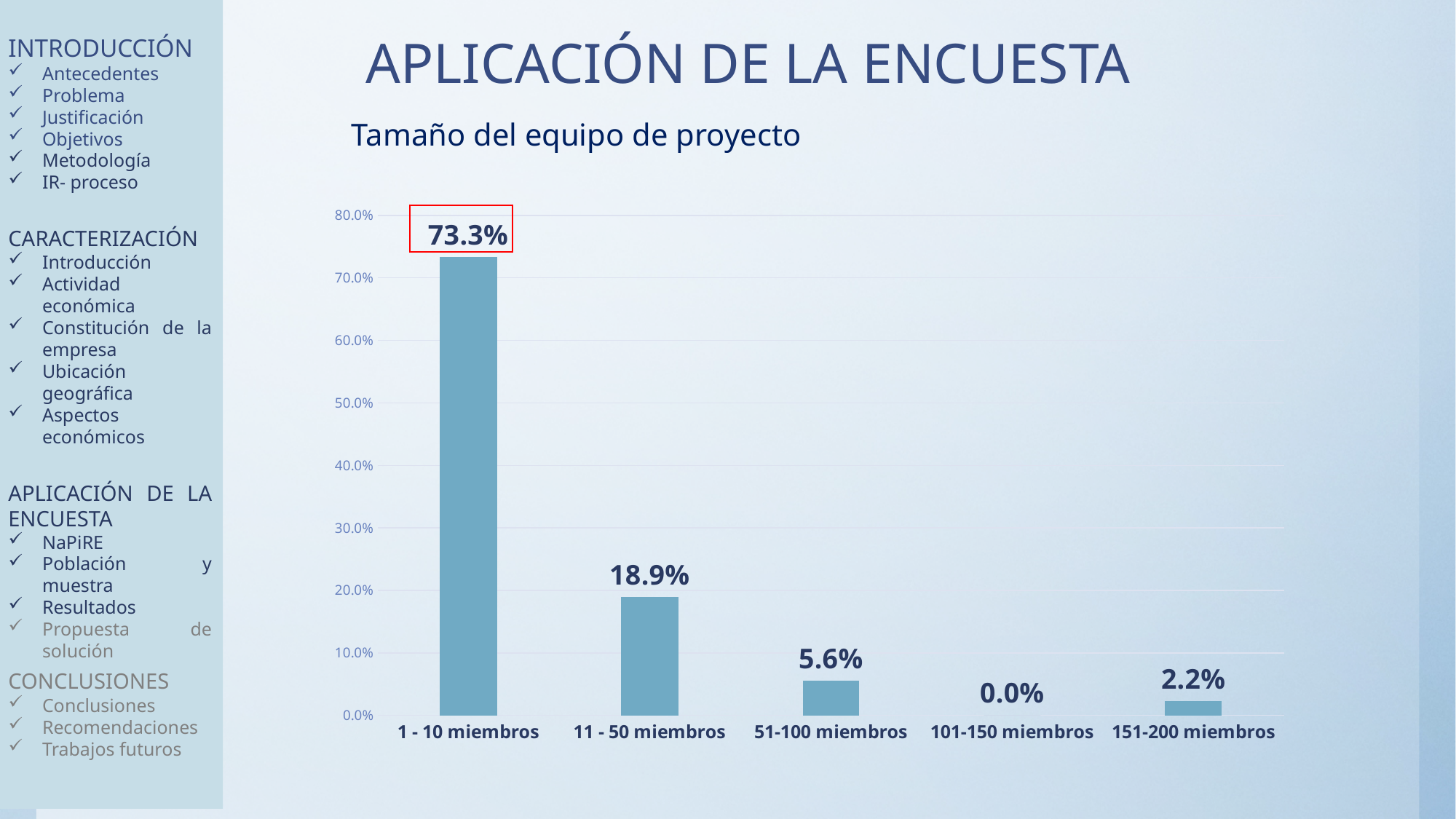
Which category has the lowest value? 101-150 miembros What is the value for 101-150 miembros? 0.0% Which is larger, the value for 51-100 miembros or the value for 151-200 miembros? 51-100 miembros What is the difference between the values for 1 - 10 miembros and 11 - 50 miembros? 54.4% What is the value for 151-200 miembros? 2.2% Which category has the highest value? 1 - 10 miembros What is the title of the chart? Tamaño del equipo de proyecto What kind of chart is shown on the slide? bar chart What is the value for 1 - 10 miembros? 73.3% What is the value for 51-100 miembros? 5.6% How many categories are shown on the x axis? 5 What is the value for 11 - 50 miembros? 18.9%